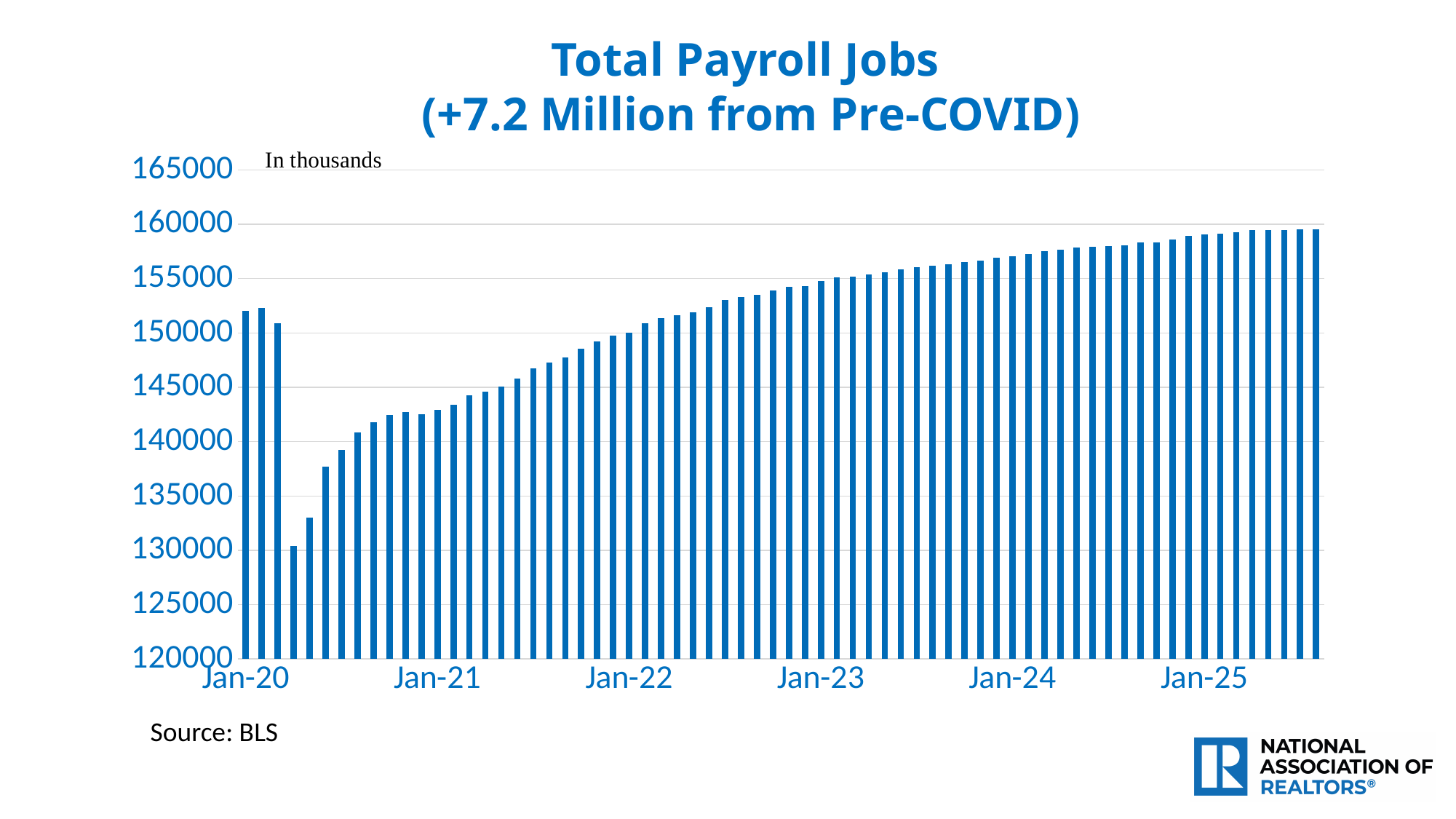
What is the title of the chart? Total Payroll Jobs (+7.2 Million from Pre-COVID) Is the value for Jan-25 greater or less than 160000? less Is the value for Jan-24 greater or less than 155000? greater How many year labels are shown on the x axis? 6 Do the values generally rise or fall from Jan-21 to Jan-25? Rise Is the value for Jan-23 greater or less than 150000? greater Which is larger, the value for Jan-25 or the value for Jan-20? Jan-25 In what units are the values on the chart expressed? In thousands What kind of chart is shown on the slide? Bar chart